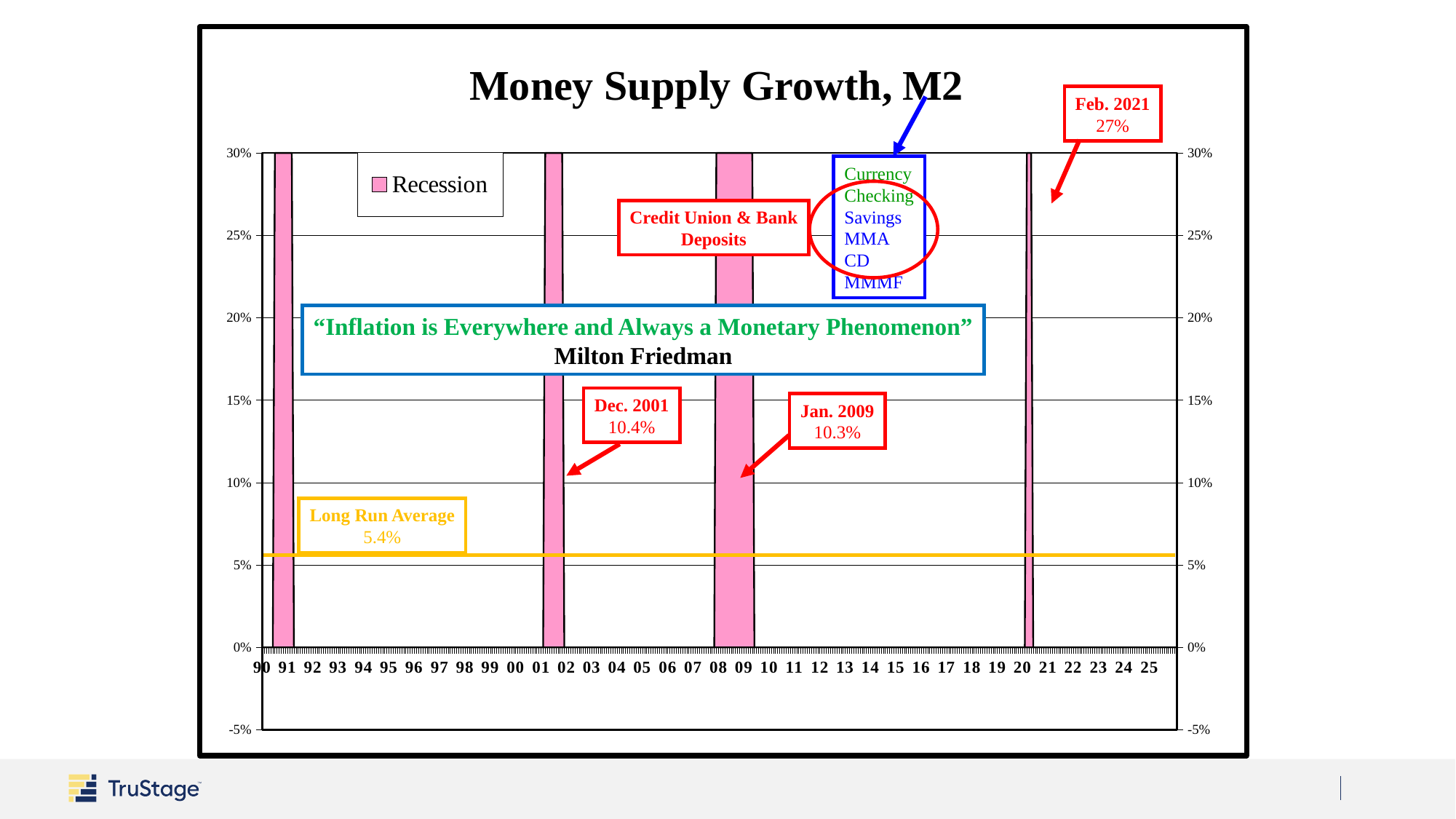
What is the Long Run Average value shown on the chart? 5.4% Is the Long Run Average line greater or less than 5%? greater How many recession bands are shaded on the chart? 4 What is the difference between the annotated Feb. 2021 value and the Dec. 2001 value? 16.6 percentage points What is the title of the chart? Money Supply Growth, M2 Which is larger, the annotated value for Dec. 2001 or for Jan. 2009? Dec. 2001 What is the difference between the annotated Dec. 2001 value and the Long Run Average? 5 percentage points What M2 growth value is annotated for Dec. 2001? 10.4% What M2 growth value is annotated for Jan. 2009? 10.3% What M2 growth value is annotated for Feb. 2021? 27% Which annotated date has the highest M2 growth value? Feb. 2021 What entry does the chart's legend list? Recession